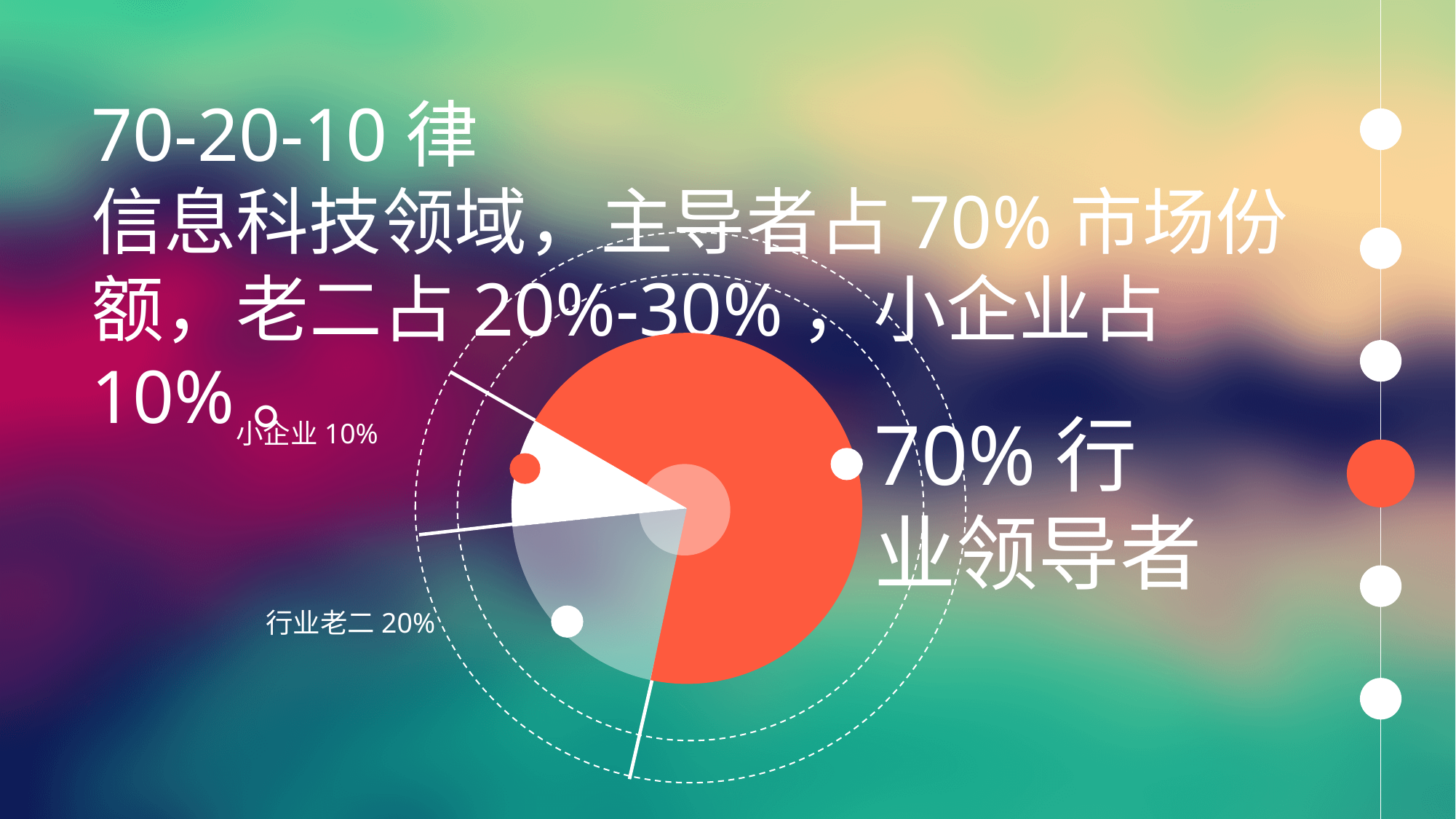
What share of the pie does 行业领导者 hold? 70% What kind of chart is shown on the slide? pie chart What is the title of the slide containing the pie chart? 70-20-10 律 What is the difference in percentage points between the 行业老二 slice and the 小企业 slice? 10 How many slices does the pie chart have? 3 What share of the pie does 行业老二 hold? 20% What is the difference in percentage points between the 行业领导者 slice and the 行业老二 slice? 50 What colour is the 行业领导者 slice of the pie chart? orange What share of the pie does 小企业 hold? 10% Which slice of the pie chart is the largest? 行业领导者 Which is larger, the 行业老二 slice or the 小企业 slice? 行业老二 Which slice of the pie chart is the smallest? 小企业